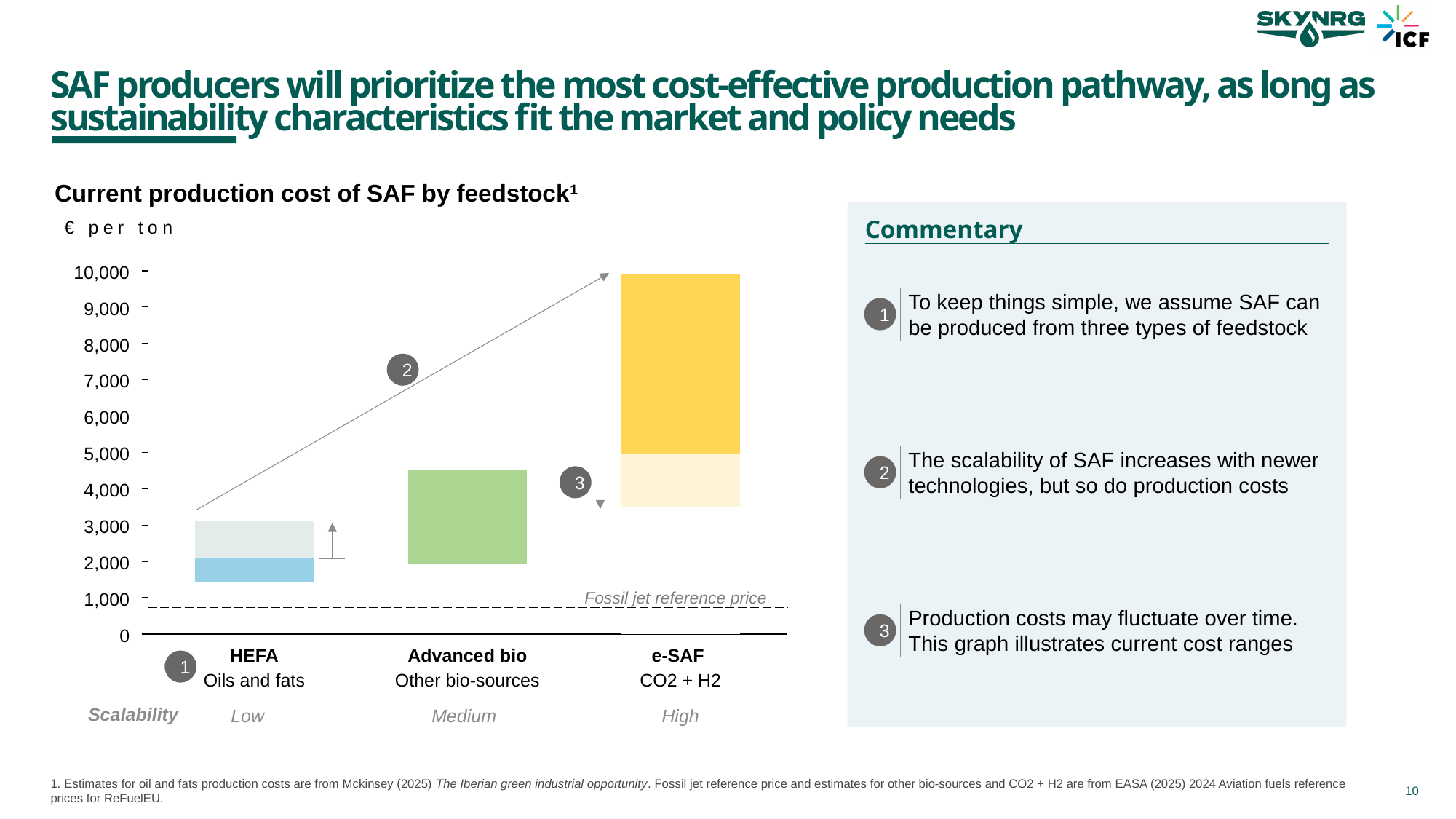
Is the bottom of the HEFA cost range greater or less than 1,000 € per ton? greater Is the fossil jet reference price greater or less than 1,000 € per ton? less What kind of chart is shown on the slide? Bar chart Which feedstock has the lowest production cost range in the chart? HEFA What unit is used on the y axis of the chart? € per ton Is the top of the Advanced bio cost range greater or less than 5,000 € per ton? less What scalability level is assigned to e-SAF in the chart? High Which has a higher production cost range, Advanced bio or HEFA? Advanced bio How many feedstock categories are shown on the x axis of the chart? 3 Which feedstock has the highest production cost range in the chart? e-SAF